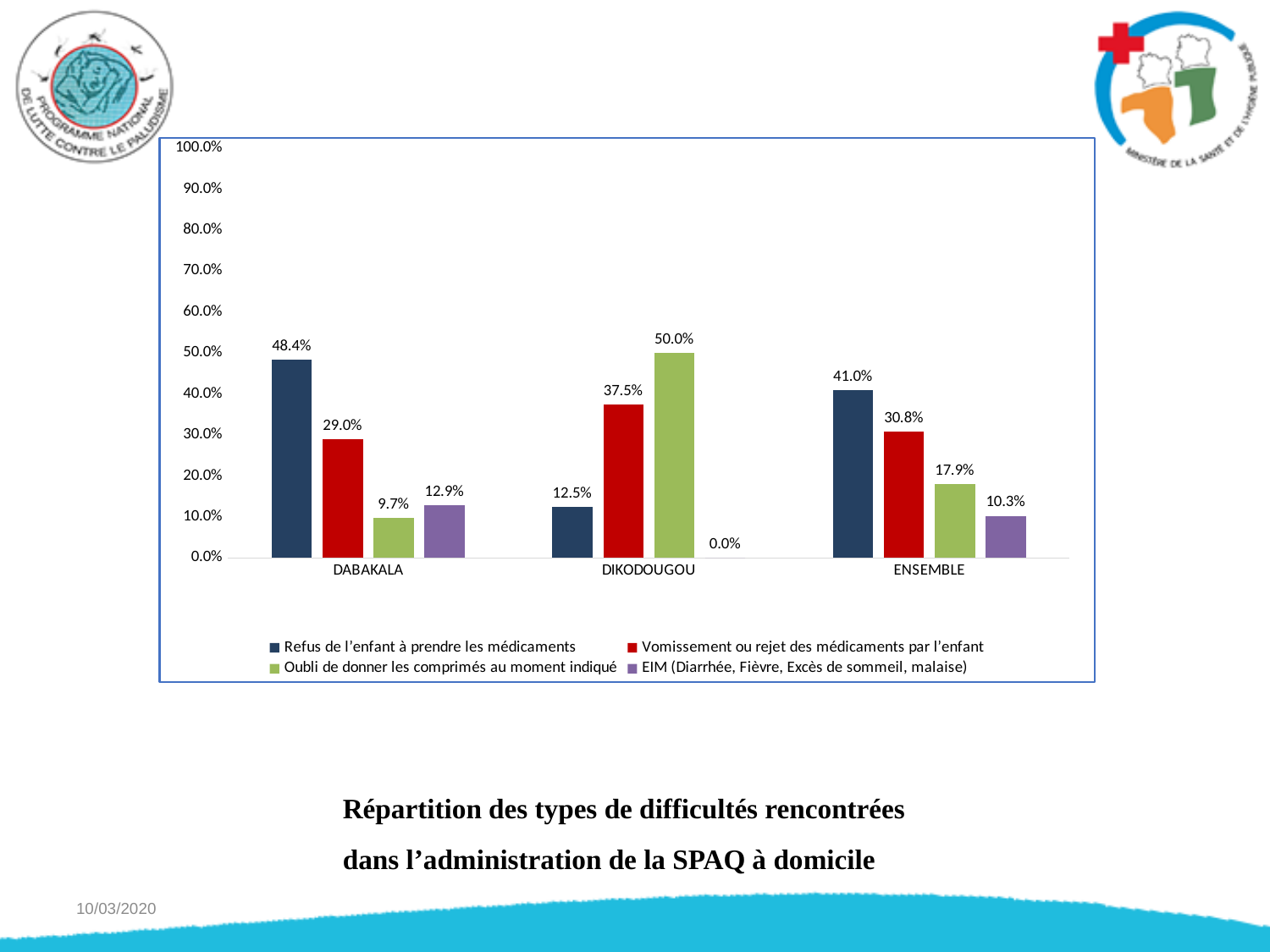
What is the value for 'Vomissement ou rejet des médicaments par l'enfant' in ENSEMBLE? 30.8% What is the value for 'Oubli de donner les comprimés au moment indiqué' in DIKODOUGOU? 50.0% What is the value for 'Refus de l'enfant à prendre les médicaments' in DABAKALA? 48.4% What is the difference between 'Refus de l'enfant à prendre les médicaments' and 'Vomissement ou rejet des médicaments par l'enfant' in DABAKALA? 19.4% What kind of chart is shown on the slide? Bar chart Which series has the highest value in DIKODOUGOU? Oubli de donner les comprimés au moment indiqué How many categories are shown on the x axis? 3 How many series does the legend list? 4 Which series has the lowest value in DABAKALA? Oubli de donner les comprimés au moment indiqué Which is larger in ENSEMBLE: 'Refus de l'enfant à prendre les médicaments' or 'Vomissement ou rejet des médicaments par l'enfant'? Refus de l'enfant à prendre les médicaments What is the value for 'EIM (Diarrhée, Fièvre, Excès de sommeil, malaise)' in ENSEMBLE? 10.3% What is the value for 'EIM (Diarrhée, Fièvre, Excès de sommeil, malaise)' in DIKODOUGOU? 0.0%